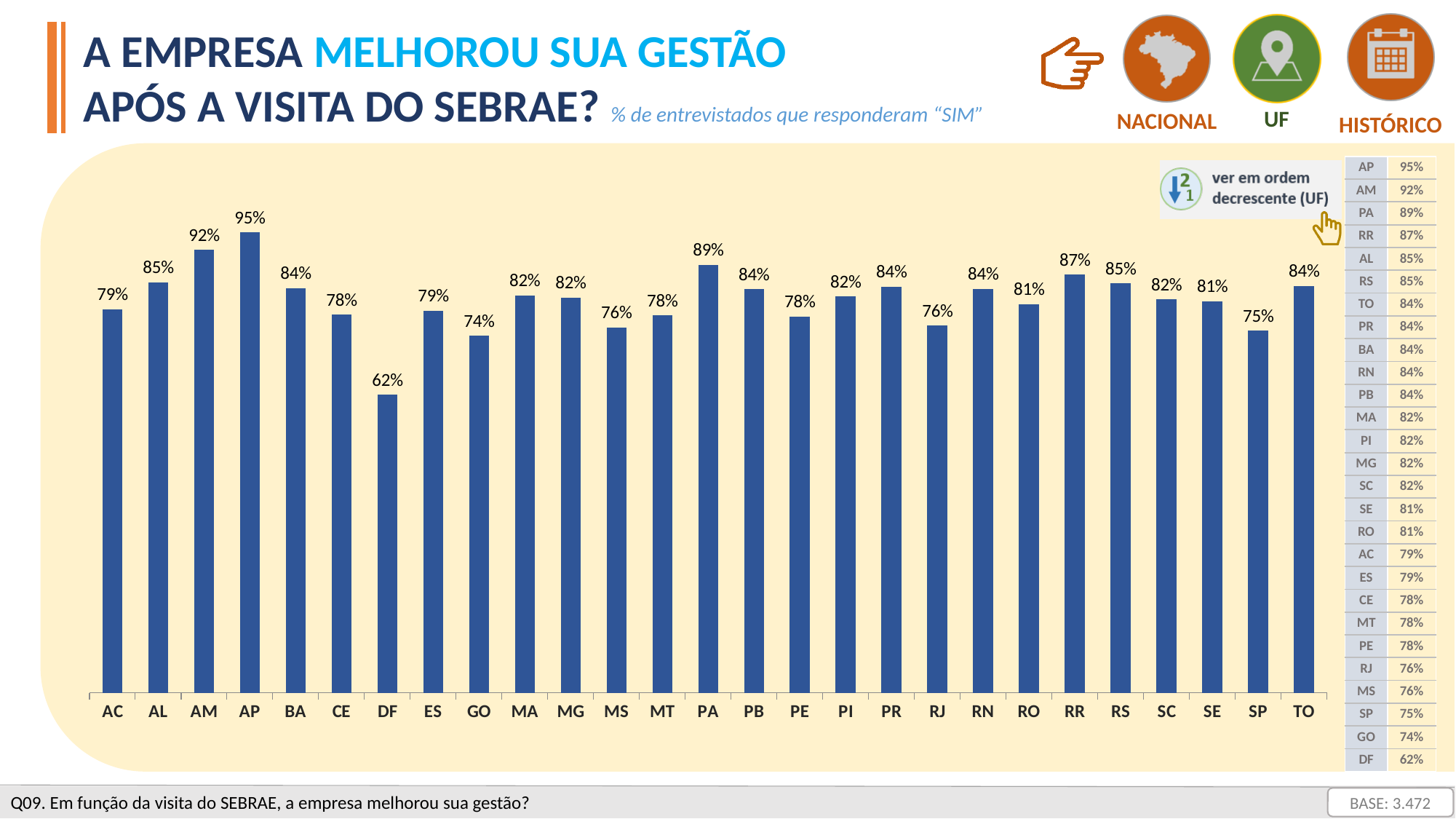
What is the value for PA? 89% Which state (UF) has the highest value? AP What is the difference between the values for AM and GO? 18% Which state (UF) has the lowest value? DF What is the value for SP? 75% What is the value for DF? 62% What kind of chart is shown on the slide? Bar chart What does the subtitle say the chart values represent? % de entrevistados que responderam "SIM" What is the difference between the values for AP and DF? 33% What is the value for AP? 95% How many states (UF) are shown on the x axis of the chart? 27 Which has a larger value, RR or RJ? RR